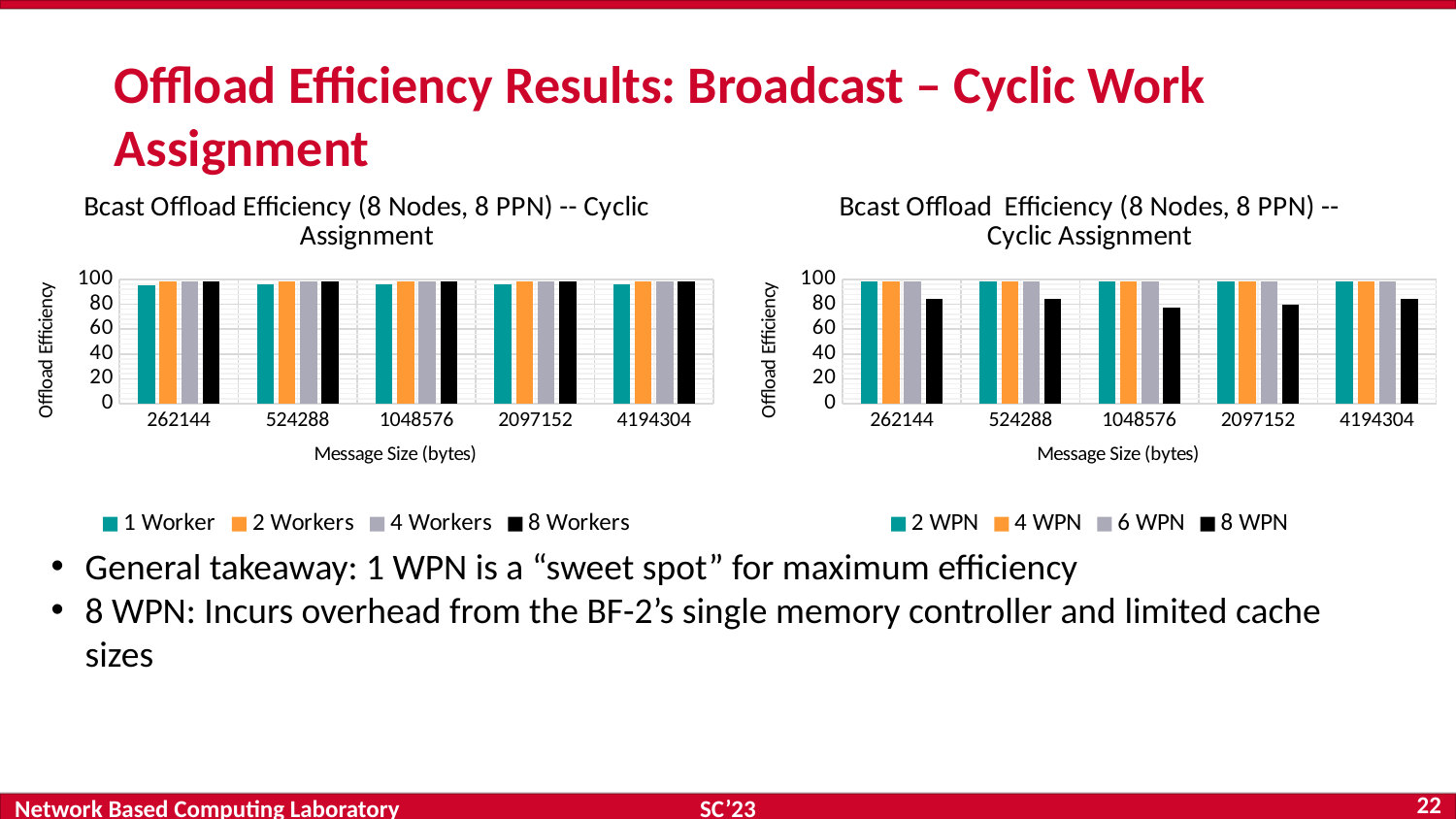
What are the legend entries of the right chart? 2 WPN, 4 WPN, 6 WPN, 8 WPN In the right chart, is the value for 8 WPN at message size 1048576 greater or less than 100? less In the right chart, which is larger at message size 1048576: 2 WPN or 8 WPN? 2 WPN How many series does the legend of the left chart list? 4 In the right chart, which series has the lowest value at message size 262144? 8 WPN In the right chart, is the value for 8 WPN at message size 4194304 greater or less than 60? greater What is the x-axis label of the left chart? Message Size (bytes) What type of chart is the left chart on the slide? bar chart In the left chart, is the value for 8 Workers at message size 2097152 greater or less than 80? greater In the right chart, which series has the lowest value at message size 2097152? 8 WPN How many message sizes are shown on the x axis of the right chart? 5 How many series does the legend of the right chart list? 4